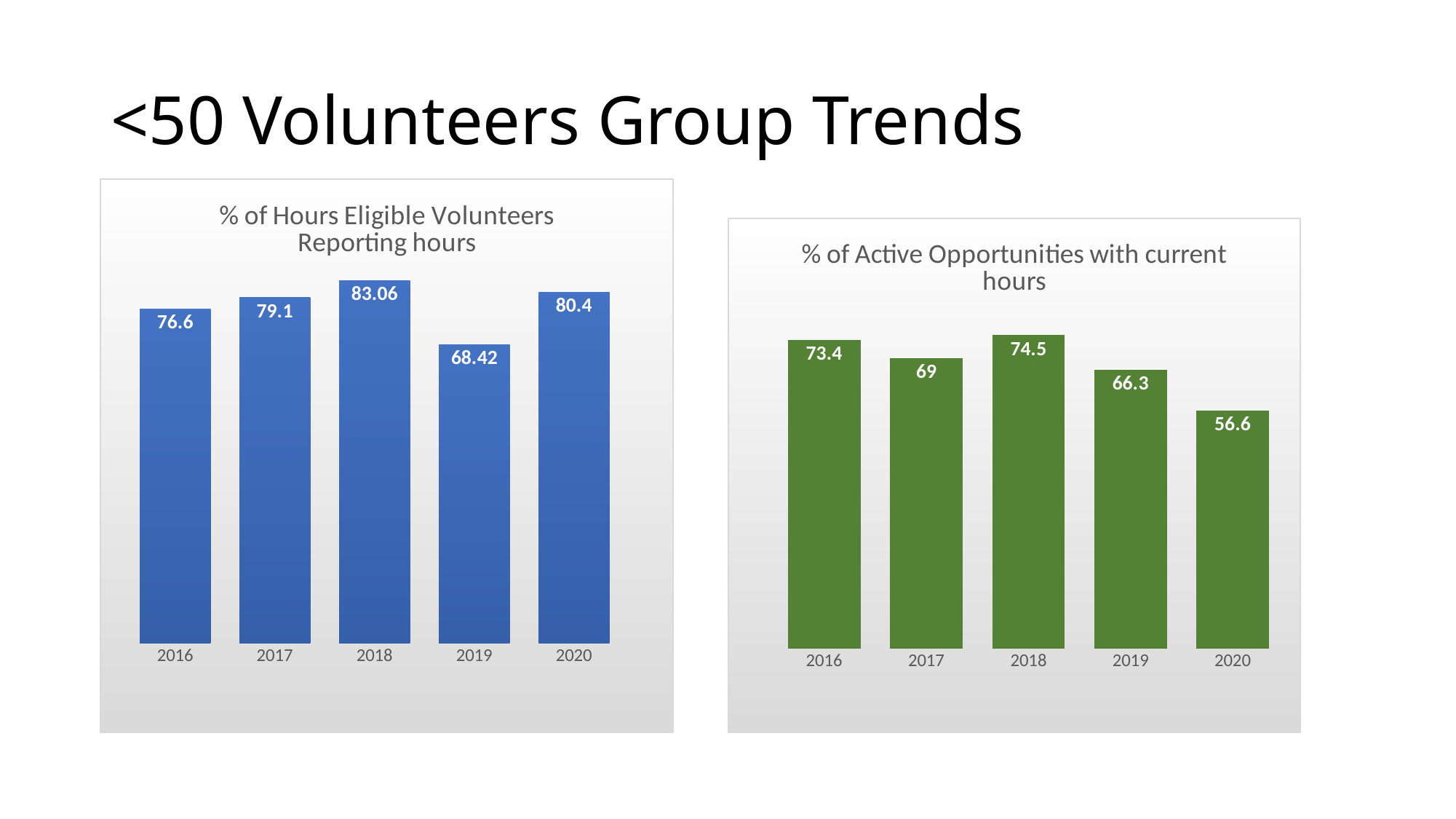
In the '% of Active Opportunities with current hours' chart, do the values rise or fall from 2018 to 2020? Fall What kind of chart is the '% of Hours Eligible Volunteers Reporting hours' chart? Bar chart How many years are shown in the '% of Active Opportunities with current hours' chart? 5 In the '% of Hours Eligible Volunteers Reporting hours' chart, which is larger, the value for 2016 or the value for 2020? 2020 In the '% of Hours Eligible Volunteers Reporting hours' chart, what is the value for 2018? 83.06 In the '% of Hours Eligible Volunteers Reporting hours' chart, which year has the lowest value? 2019 In the '% of Active Opportunities with current hours' chart, what is the value for 2020? 56.6 In the '% of Active Opportunities with current hours' chart, what is the difference between the 2016 and 2020 values? 16.8 In the '% of Active Opportunities with current hours' chart, which year has the highest value? 2018 In the '% of Active Opportunities with current hours' chart, which is larger, the value for 2017 or the value for 2019? 2017 In the '% of Hours Eligible Volunteers Reporting hours' chart, what is the difference between the 2018 and 2019 values? 14.64 What colour are the bars in the '% of Active Opportunities with current hours' chart? Green